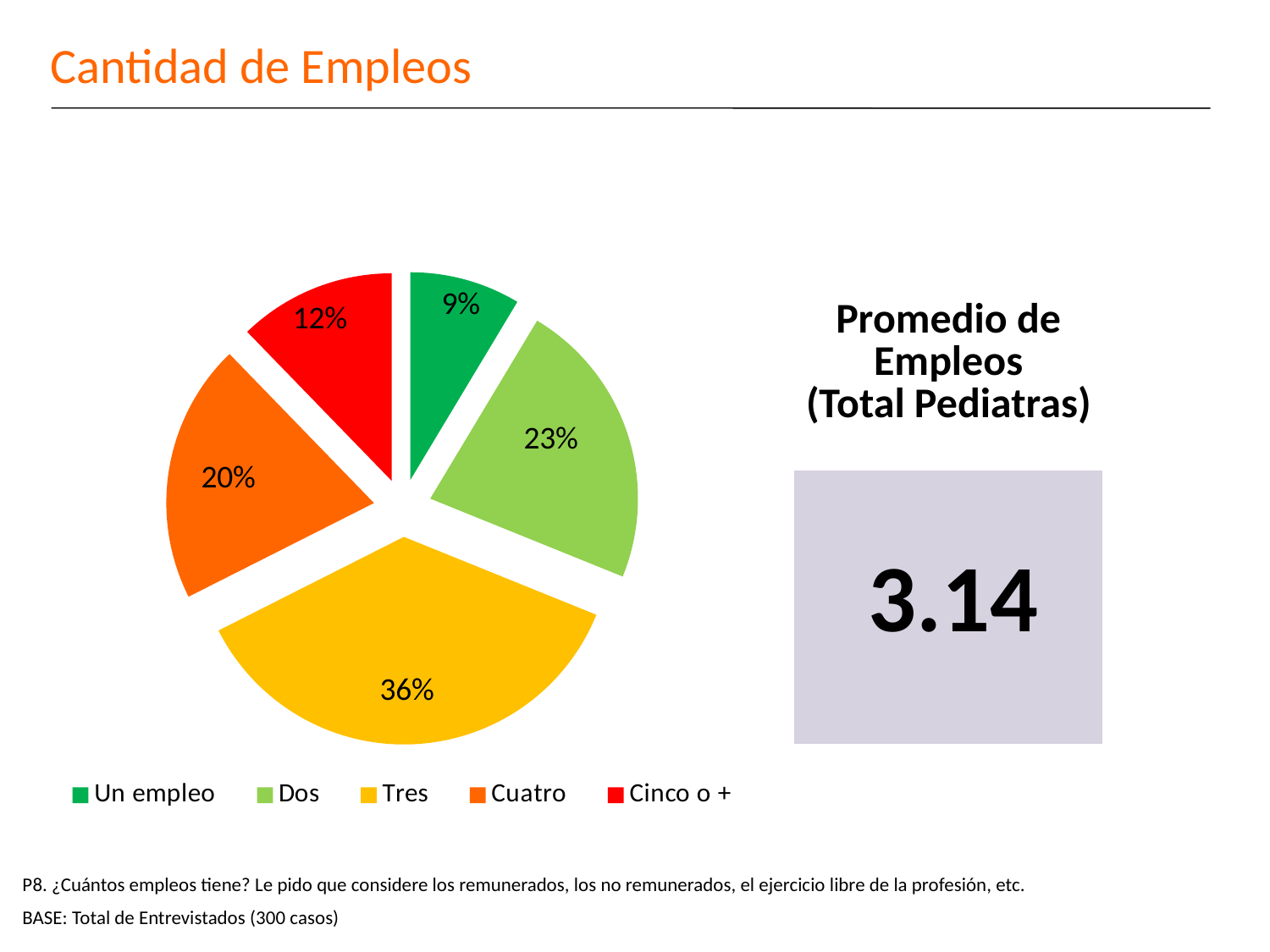
What percentage of respondents have 'Cuatro' (four) jobs? 20% Which is larger, the share for 'Cuatro' or the share for 'Cinco o +'? Cuatro What is the average number of jobs (Promedio de Empleos) shown on the slide? 3.14 Which category has the smallest share of the pie? Un empleo What percentage of respondents have 'Tres' (three) jobs? 36% What kind of chart is shown on the slide? Pie chart What colour is the slice for 'Dos'? Light green What percentage of respondents have 'Un empleo' (one job)? 9% Which category has the largest share of the pie? Tres How many categories does the pie chart show? 5 What is the difference in percentage points between 'Tres' and 'Dos'? 13 What percentage of respondents have 'Cinco o +' jobs? 12%